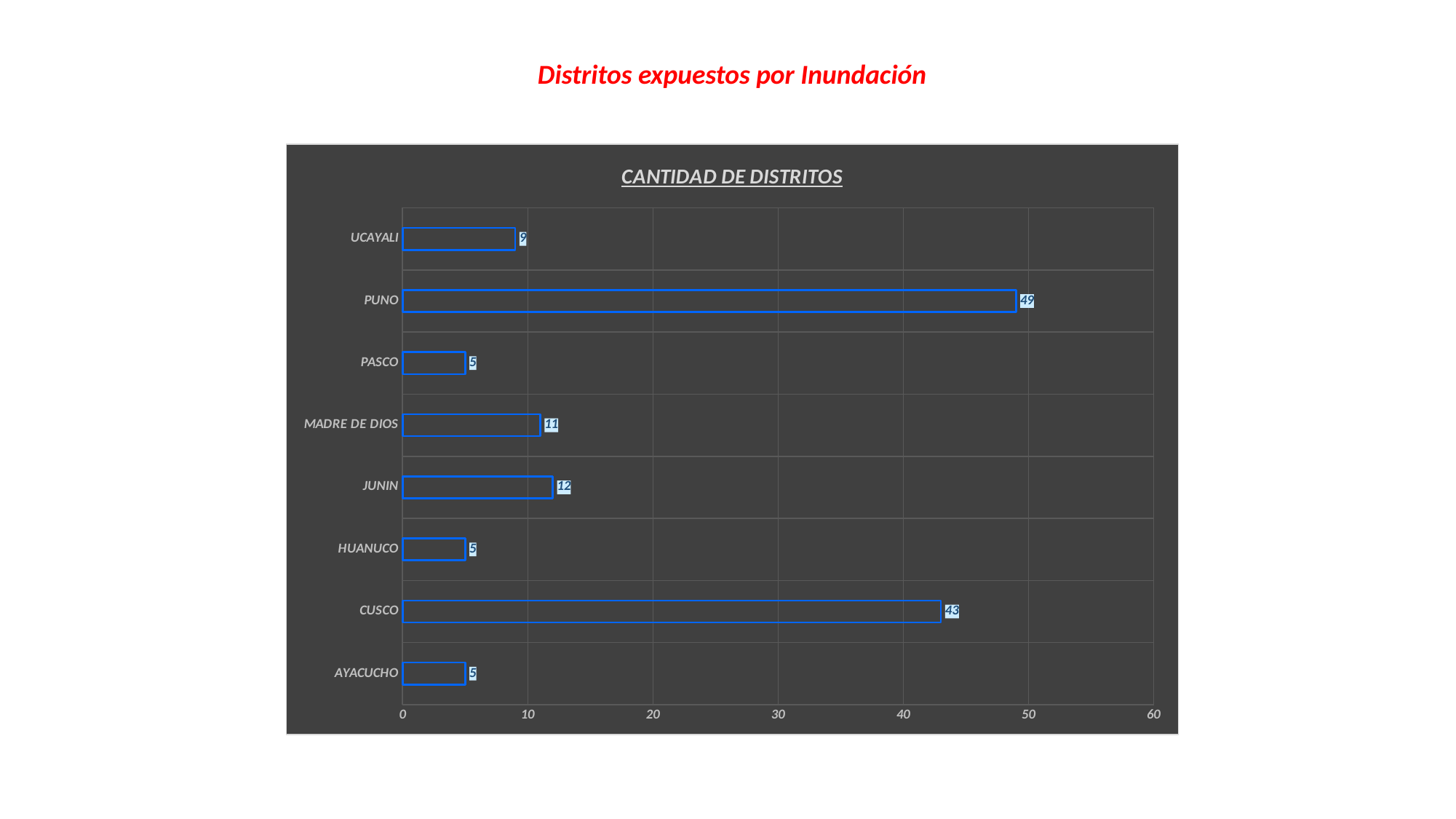
What is the title of the chart? CANTIDAD DE DISTRITOS What is the value for UCAYALI? 9 Is the value for CUSCO greater or less than 40? greater What is the difference between the values for JUNIN and MADRE DE DIOS? 1 Which category has the highest value? PUNO What kind of chart is shown? bar chart What is the value for MADRE DE DIOS? 11 Which is larger, the value for JUNIN or the value for UCAYALI? JUNIN How many categories are shown in the chart? 8 What is the difference between the values for PUNO and CUSCO? 6 What is the value for PUNO? 49 What is the value for CUSCO? 43